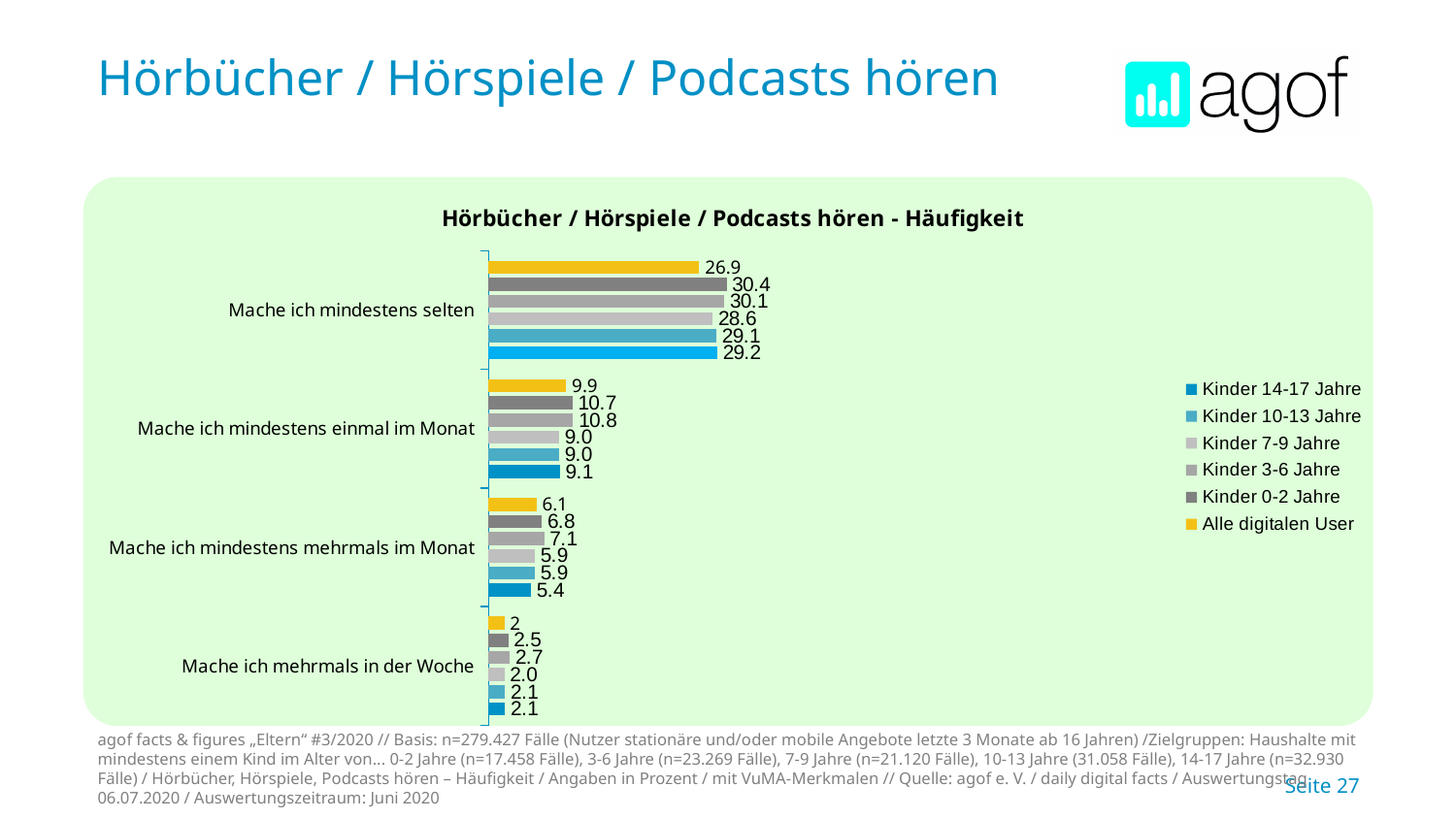
What is the value for Kinder 14-17 Jahre in the category 'Mache ich mindestens mehrmals im Monat'? 5.4 How many series does the legend list? 6 What is the difference between Kinder 0-2 Jahre and Alle digitalen User in the category 'Mache ich mindestens selten'? 3.5 What is the value for Alle digitalen User in the category 'Mache ich mindestens selten'? 26.9 What is the title of the chart? Hörbücher / Hörspiele / Podcasts hören - Häufigkeit In the category 'Mache ich mindestens einmal im Monat', which is larger: Kinder 3-6 Jahre or Kinder 7-9 Jahre? Kinder 3-6 Jahre Which series has the highest value in the category 'Mache ich mindestens selten'? Kinder 0-2 Jahre What is the value for Kinder 0-2 Jahre in the category 'Mache ich mindestens einmal im Monat'? 10.7 Which series has the lowest value in the category 'Mache ich mindestens mehrmals im Monat'? Kinder 14-17 Jahre How many categories are shown on the chart? 4 What is the value for Kinder 3-6 Jahre in the category 'Mache ich mehrmals in der Woche'? 2.7 What type of chart is shown on the slide? bar chart